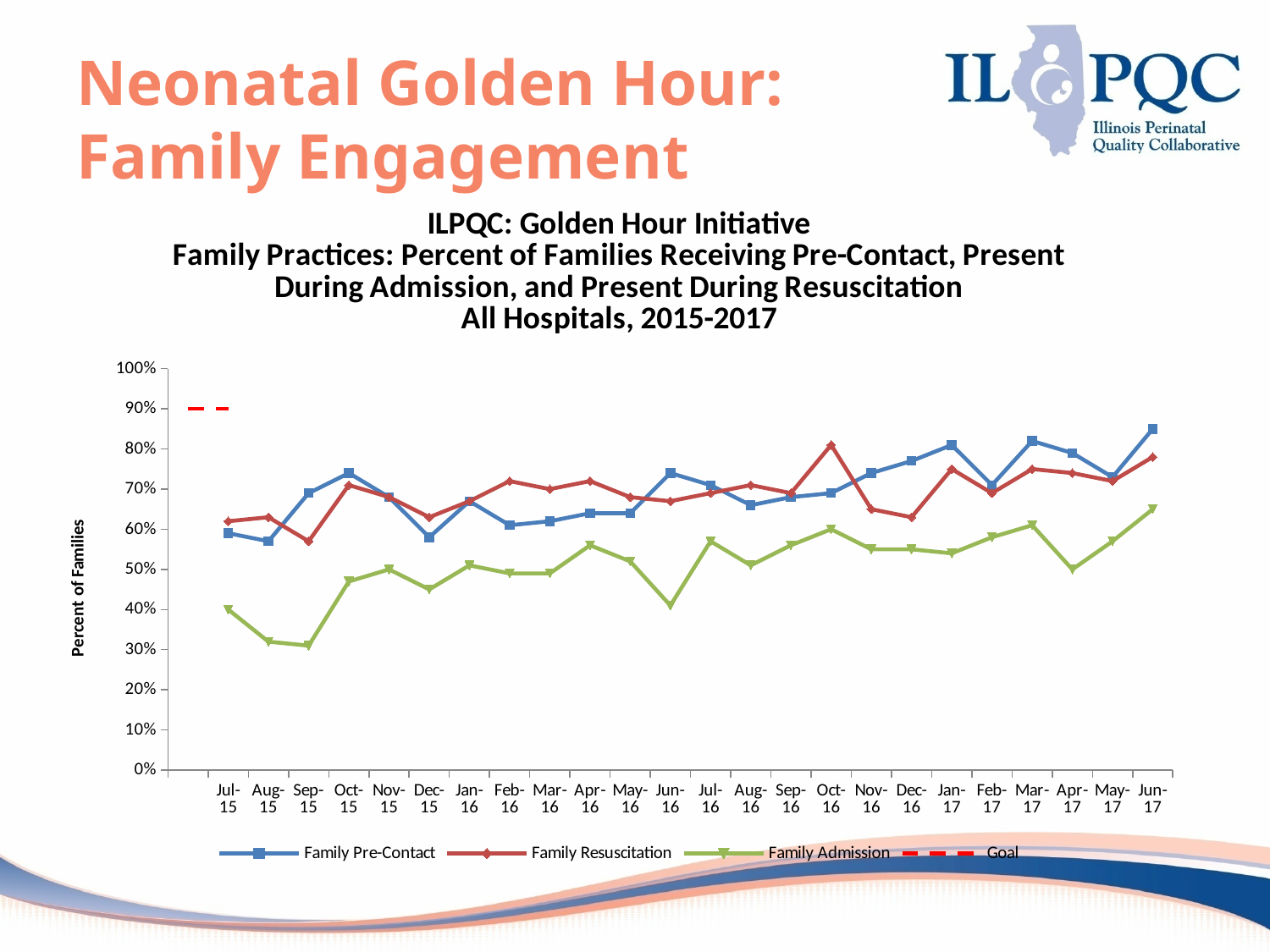
What is the label of the vertical axis? Percent of Families In Jul-15, which series has the higher value: Family Pre-Contact or Family Admission? Family Pre-Contact What kind of chart is shown on the slide? line chart How many months are plotted along the x axis of the chart? 24 Is the value for Family Admission in Jun-16 greater or less than 50%? less Is the value for Family Admission in Dec-15 greater or less than 50%? less Is the value for Family Resuscitation in Sep-15 greater or less than 60%? less Overall, does the Family Admission series rise or fall from Jul-15 to Jun-17? rise At what percentage is the Goal line drawn on the chart? 90% In which month does the Family Admission series reach its highest value? Jun-17 How many entries does the chart legend list? 4